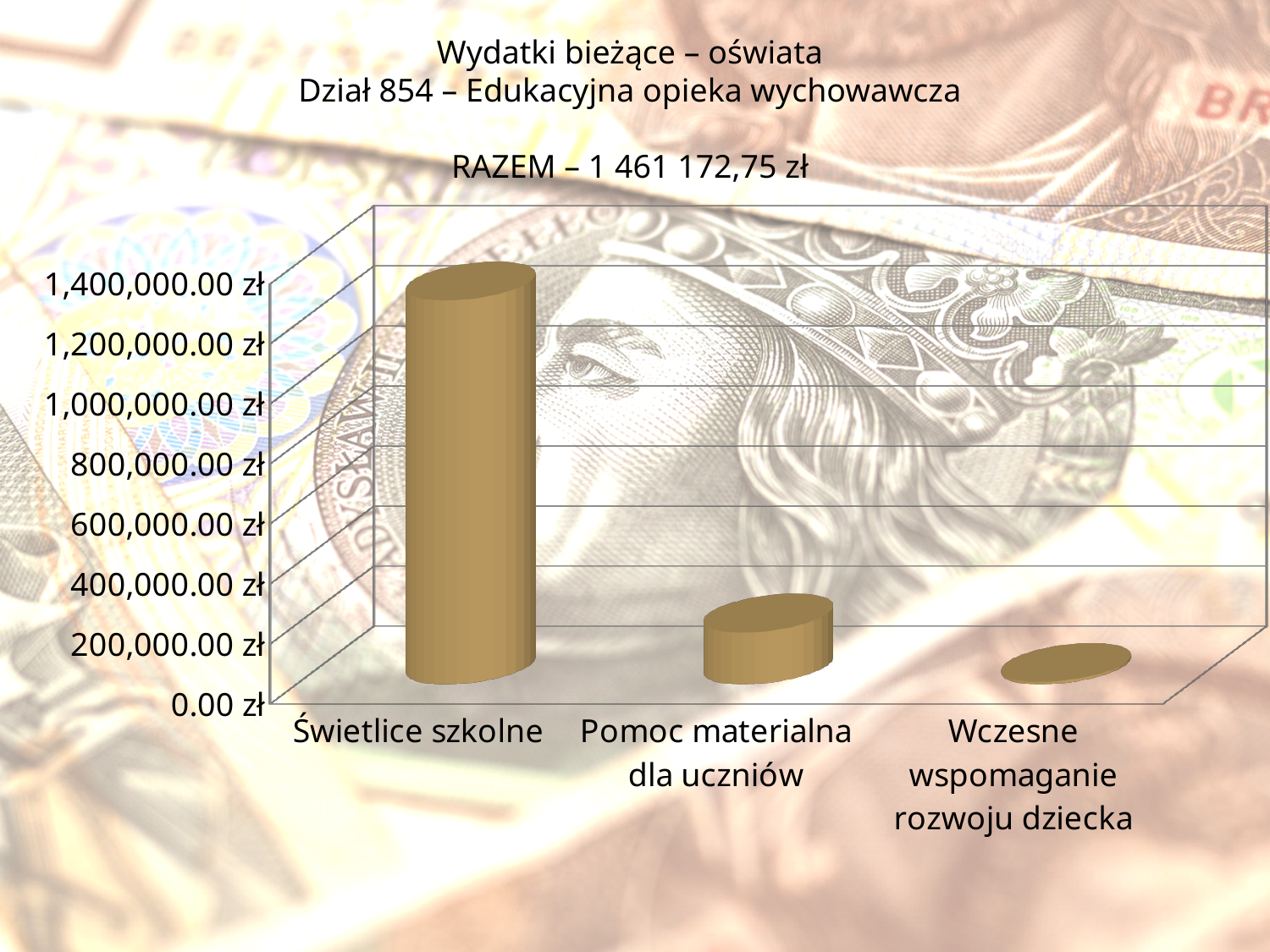
Which category has the highest value in the chart? Świetlice szkolne Do the values rise or fall from left to right along the x axis? fall What kind of chart is shown on the slide? bar chart Which category has the lowest value in the chart? Wczesne wspomaganie rozwoju dziecka What total (RAZEM) is stated above the chart? 1 461 172,75 zł Which budget section (Dział) is named in the chart title? Dział 854 – Edukacyjna opieka wychowawcza How many categories are shown on the x axis of the chart? 3 Which is larger, the value for Pomoc materialna dla uczniów or the value for Wczesne wspomaganie rozwoju dziecka? Pomoc materialna dla uczniów Which is larger, the value for Świetlice szkolne or the value for Pomoc materialna dla uczniów? Świetlice szkolne Is the value for Świetlice szkolne greater or less than 1,000,000.00 zł? greater Is the value for Wczesne wspomaganie rozwoju dziecka greater or less than 200,000.00 zł? less Is the value for Pomoc materialna dla uczniów greater or less than 400,000.00 zł? less